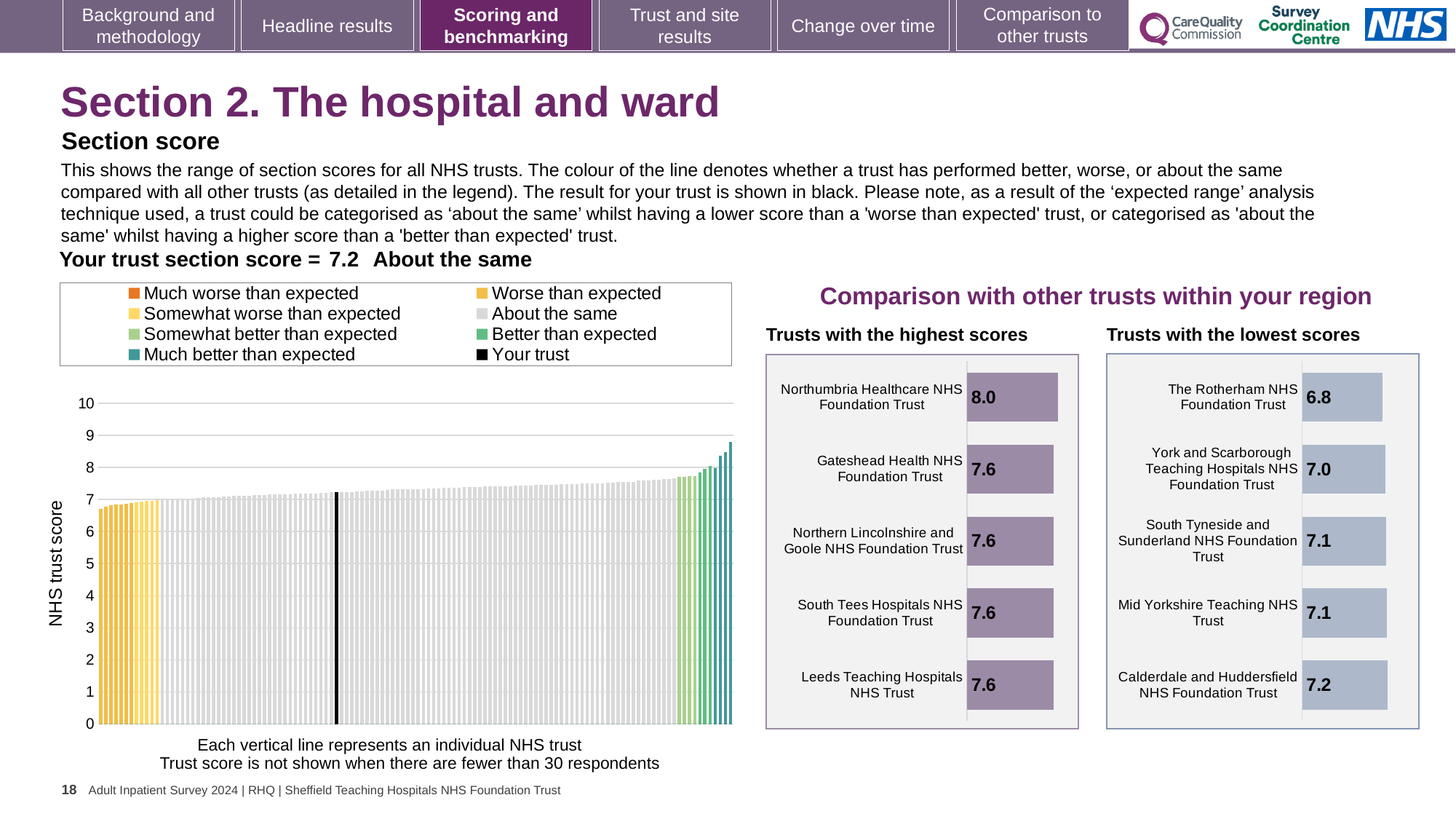
In the 'Trusts with the lowest scores' chart, which is larger: the score for York and Scarborough Teaching Hospitals NHS Foundation Trust or The Rotherham NHS Foundation Trust? York and Scarborough Teaching Hospitals NHS Foundation Trust In the 'Trusts with the highest scores' chart, how many trusts are listed? 5 In the large chart on the left, is the value of the tallest bar greater or less than 8? greater How many entries does the legend of the large chart on the left list? 8 In the 'Trusts with the lowest scores' chart, which trust has the lowest score? The Rotherham NHS Foundation Trust In the 'Trusts with the lowest scores' chart, what is the score for Mid Yorkshire Teaching NHS Trust? 7.1 What kind of chart is the large chart on the left showing NHS trust scores? Bar chart In the 'Trusts with the highest scores' chart, what is the difference between the scores of Northumbria Healthcare NHS Foundation Trust and Gateshead Health NHS Foundation Trust? 0.4 In the 'Trusts with the lowest scores' chart, what is the difference between the scores of Calderdale and Huddersfield NHS Foundation Trust and The Rotherham NHS Foundation Trust? 0.4 In the 'Trusts with the highest scores' chart, which trust has the highest score? Northumbria Healthcare NHS Foundation Trust In the 'Trusts with the highest scores' chart, what is the score for Northumbria Healthcare NHS Foundation Trust? 8.0 In the 'Trusts with the lowest scores' chart, what is the score for The Rotherham NHS Foundation Trust? 6.8